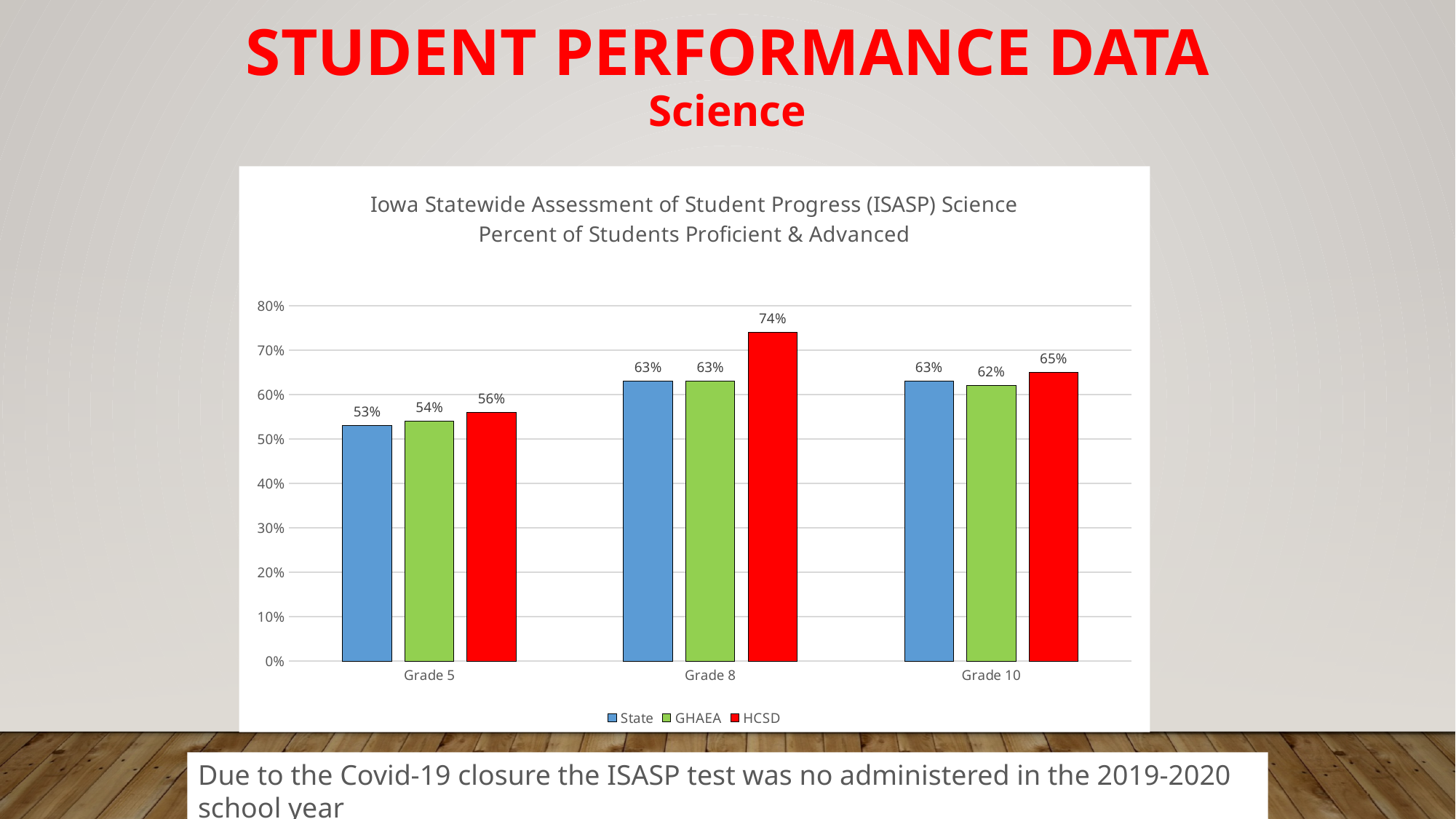
What is the GHAEA value for Grade 10? 62% What is the State value for Grade 5? 53% What is the HCSD value for Grade 8? 74% How many series does the legend list? 3 Which grade has the highest HCSD value? Grade 8 Which is larger for Grade 10, the HCSD value or the GHAEA value? HCSD Which grade has the lowest State value? Grade 5 Does the HCSD value rise or fall from Grade 5 to Grade 8? Rise What kind of chart is shown on the slide? Bar chart What is the difference between the HCSD and State values for Grade 8? 11% What colour are the HCSD bars? Red How many grade categories are shown on the x axis? 3